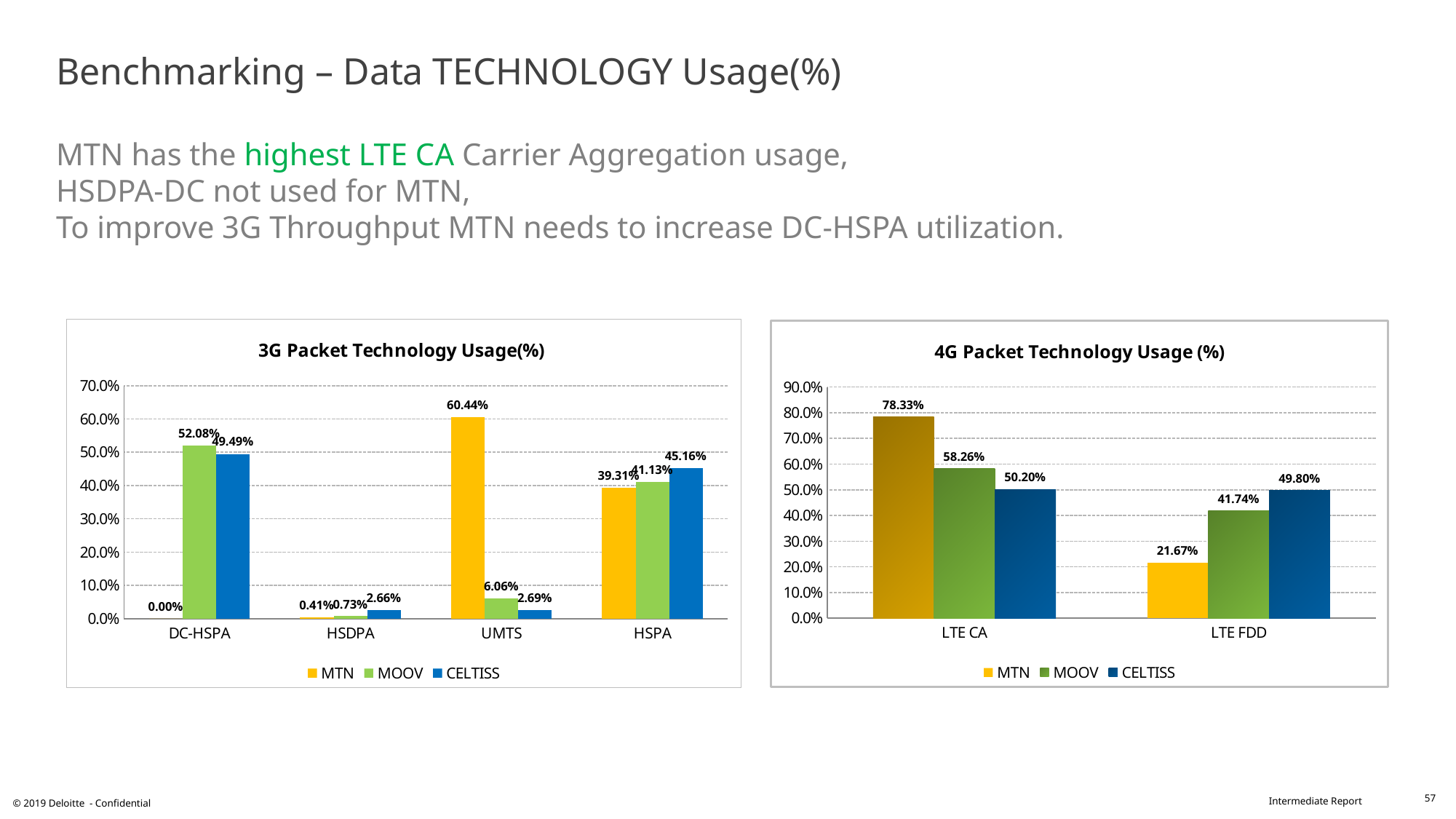
In the '4G Packet Technology Usage (%)' chart, is the CELTISS value for LTE CA larger or smaller than the CELTISS value for LTE FDD? larger In the '4G Packet Technology Usage (%)' chart, which series has the lowest value in the LTE FDD category? MTN In the '3G Packet Technology Usage(%)' chart, what is the value for CELTISS in the HSPA category? 45.16% In the '3G Packet Technology Usage(%)' chart, what is the value for MOOV in the DC-HSPA category? 52.08% How many series does the legend of the '4G Packet Technology Usage (%)' chart list? 3 In the '3G Packet Technology Usage(%)' chart, which category has the highest value for MTN? UMTS In the '4G Packet Technology Usage (%)' chart, what is the value for MTN in the LTE CA category? 78.33% In the '4G Packet Technology Usage (%)' chart, what is the value for MOOV in the LTE FDD category? 41.74% In the '3G Packet Technology Usage(%)' chart, what is the value for MTN in the UMTS category? 60.44% How many categories are shown on the x axis of the '3G Packet Technology Usage(%)' chart? 4 In the '4G Packet Technology Usage (%)' chart, what is the difference between the MTN values for LTE CA and LTE FDD? 56.66% In the '3G Packet Technology Usage(%)' chart, what is the difference between the MOOV and CELTISS values in the DC-HSPA category? 2.59%